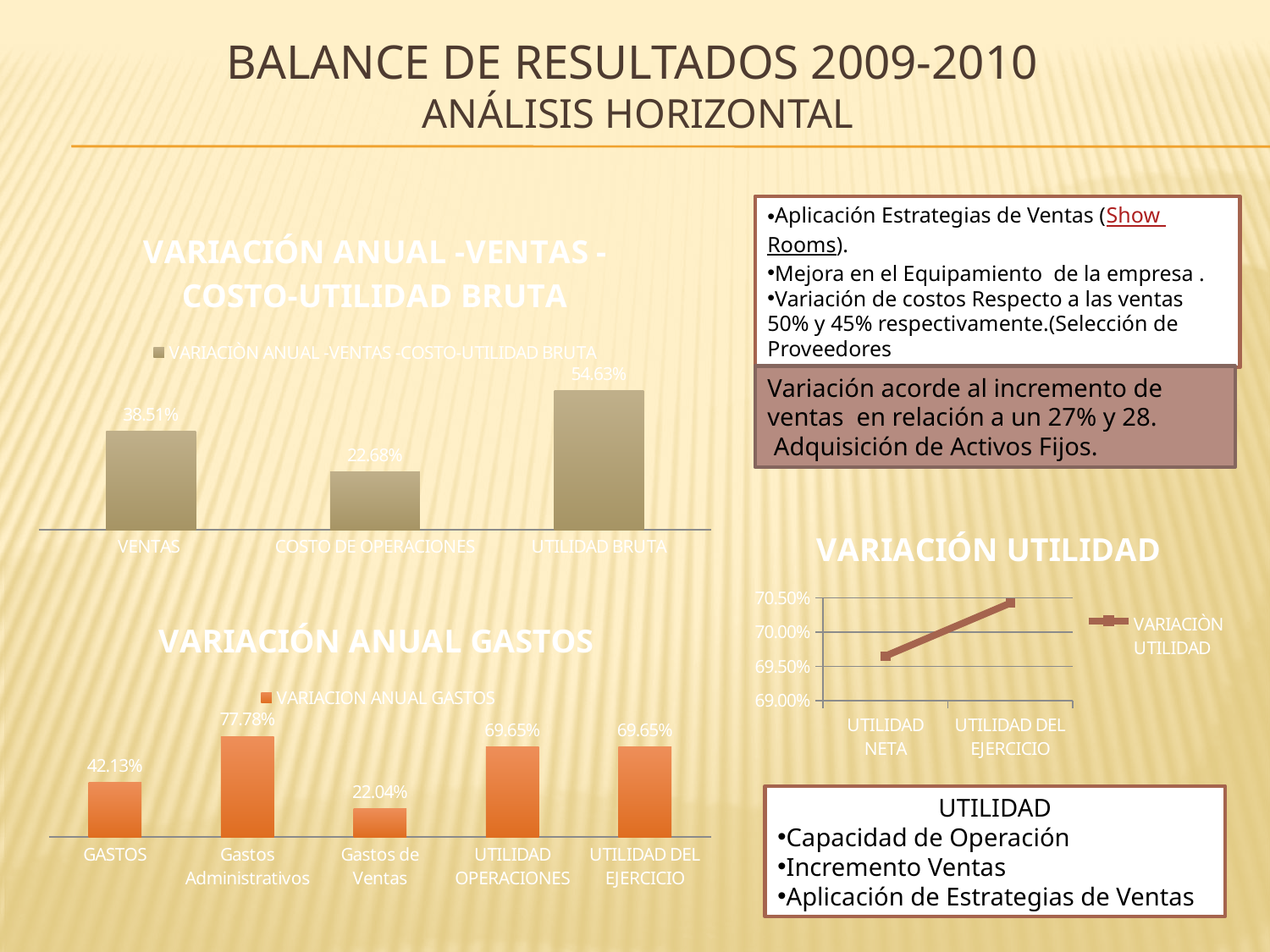
In the 'VARIACIÓN ANUAL -VENTAS -COSTO-UTILIDAD BRUTA' chart, what is the value for VENTAS? 38.51% In the 'VARIACIÓN ANUAL GASTOS' chart, which is larger, GASTOS or Gastos de Ventas? GASTOS What kind of chart is the 'VARIACIÓN UTILIDAD' chart? Line chart In the 'VARIACIÓN ANUAL GASTOS' chart, how many categories are shown? 5 In the 'VARIACIÓN UTILIDAD' chart, is the value for UTILIDAD DEL EJERCICIO greater or less than 70.00%? greater In the 'VARIACIÓN ANUAL -VENTAS -COSTO-UTILIDAD BRUTA' chart, what is the difference between UTILIDAD BRUTA and VENTAS? 16.12% In the 'VARIACIÓN ANUAL GASTOS' chart, what is the difference between Gastos Administrativos and GASTOS? 35.65% In the 'VARIACIÓN ANUAL GASTOS' chart, which category has the lowest value? Gastos de Ventas In the 'VARIACIÓN ANUAL -VENTAS -COSTO-UTILIDAD BRUTA' chart, which category has the highest value? UTILIDAD BRUTA In the 'VARIACIÓN UTILIDAD' chart, do the values rise or fall from UTILIDAD NETA to UTILIDAD DEL EJERCICIO? rise In the 'VARIACIÓN ANUAL GASTOS' chart, what is the value for Gastos Administrativos? 77.78% In the 'VARIACIÓN ANUAL -VENTAS -COSTO-UTILIDAD BRUTA' chart, which category has the lowest value? COSTO DE OPERACIONES